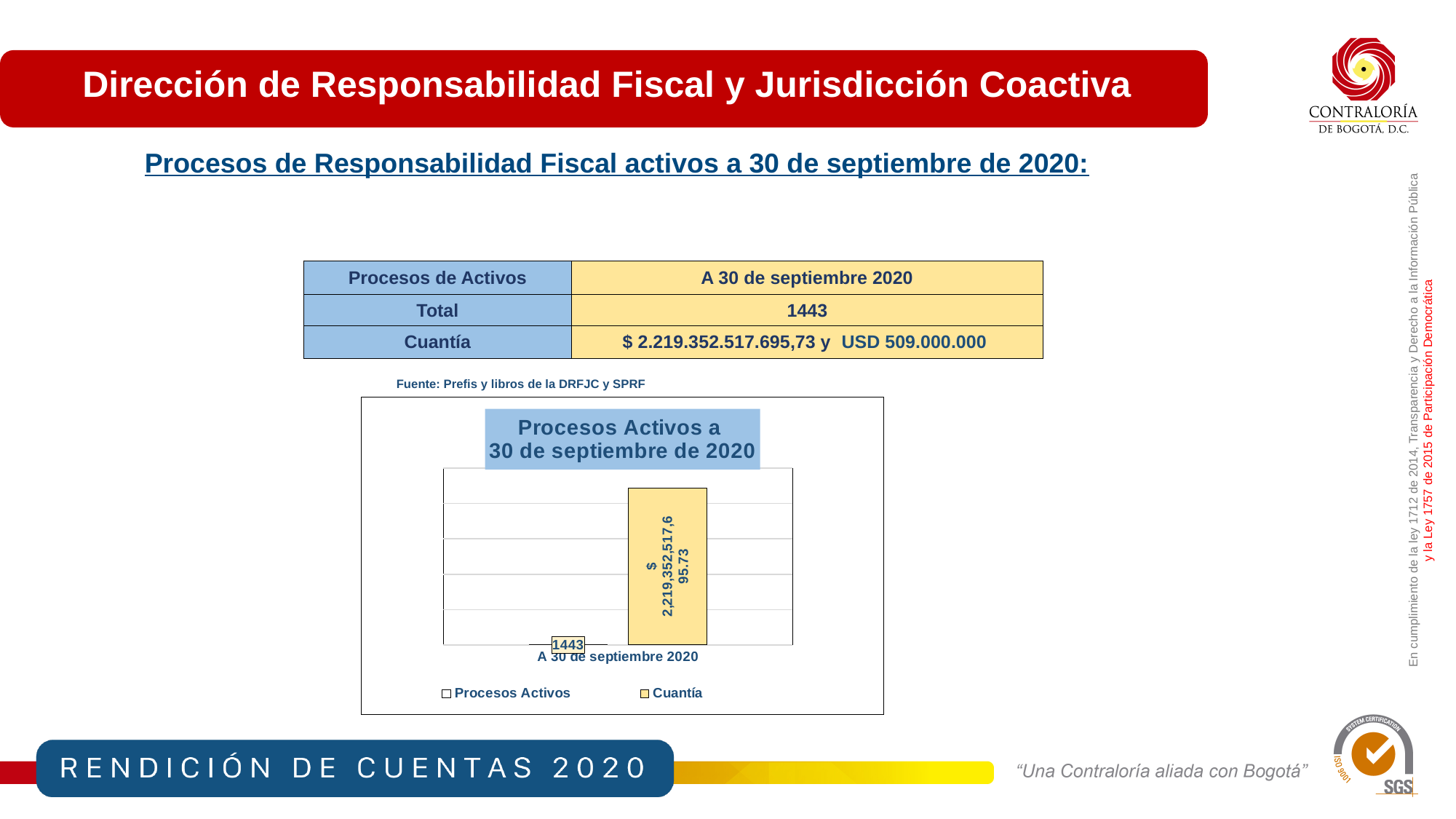
What is the title of the chart? Procesos Activos a 30 de septiembre de 2020 What colour is the Cuantía bar in the chart? yellow What is the value of the Cuantía bar in the chart? $ 2,219,352,517,695.73 Which series has the highest value in the chart? Cuantía How many series does the legend of the chart list? 2 What is the value of the Procesos Activos bar in the chart? 1443 Which series has the taller bar in the chart, Procesos Activos or Cuantía? Cuantía Which series has the lowest value in the chart? Procesos Activos What kind of chart is shown on the slide? bar chart How many categories are shown on the x axis of the chart? 1